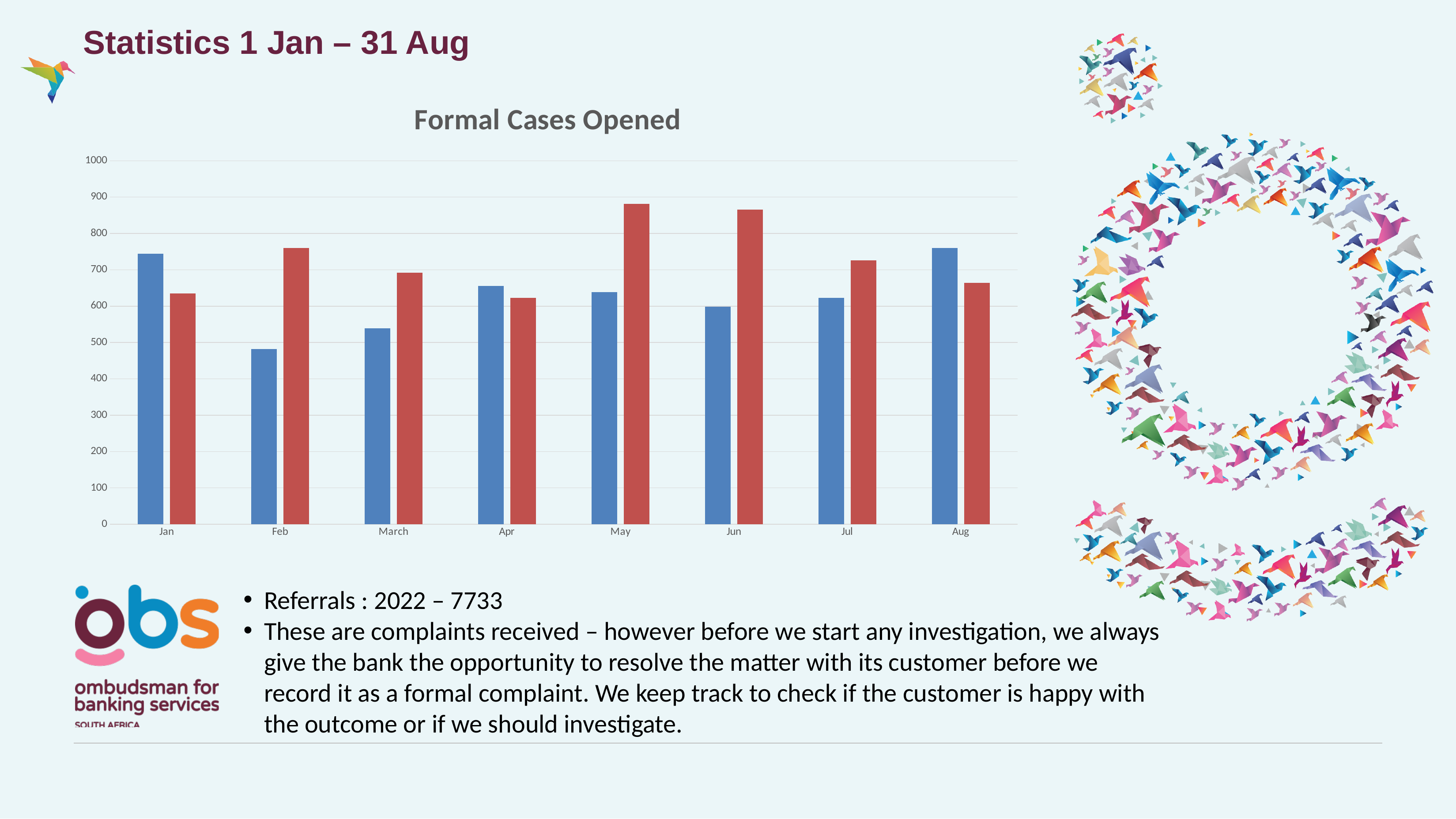
Is the value of the blue bar for Aug greater or less than 700? greater What kind of chart is shown on the slide? Bar chart Is the value of the red bar for Aug greater or less than 700? less In Feb, which bar is taller, the blue bar or the red bar? Red bar How many months are shown on the x axis of the chart? 8 Is the value of the red bar for May greater or less than 800? greater What is the title of the chart? Formal Cases Opened In which month is the blue bar the lowest? Feb What two colours are used for the bars in the chart? Blue and red In which month is the red bar the highest? May In Jan, which bar is taller, the blue bar or the red bar? Blue bar